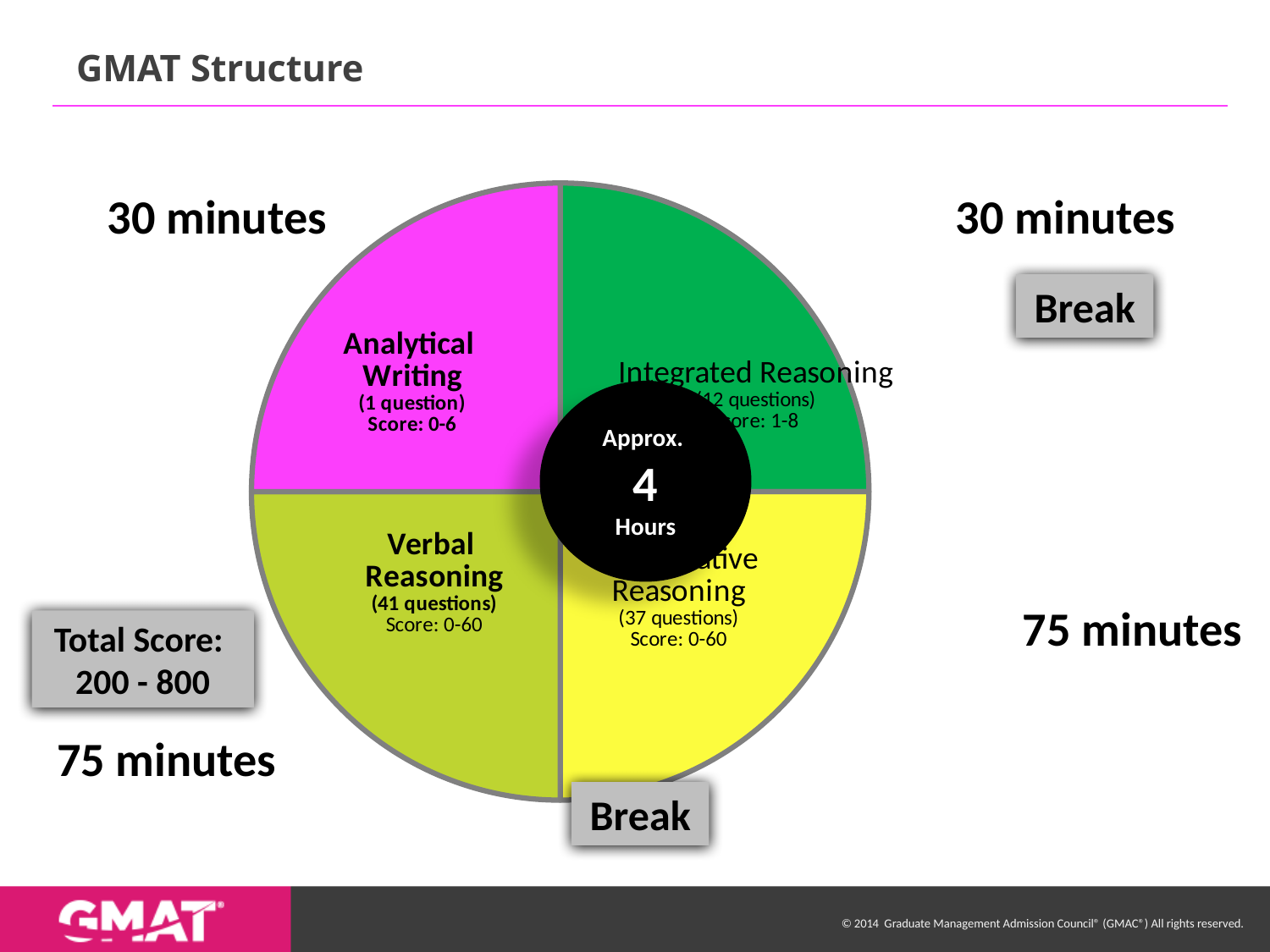
What kind of chart is shown on the slide? pie chart How many questions does the Quantitative Reasoning section have according to the chart? 37 questions Which section has more questions, Verbal Reasoning or Quantitative Reasoning? Verbal Reasoning What is the score range shown for the Verbal Reasoning section? 0-60 What is the score range shown for the Analytical Writing section? 0-6 What colour is the Analytical Writing slice of the pie chart? magenta How many sections does the pie chart divide the GMAT into? 4 How many questions does the Verbal Reasoning section have according to the chart? 41 questions What is the score range shown for the Integrated Reasoning section? 1-8 What is the difference in the number of questions between Verbal Reasoning and Quantitative Reasoning? 4 What approximate total duration is shown in the centre of the pie chart? Approx. 4 Hours How many questions does the Analytical Writing section have according to the chart? 1 question